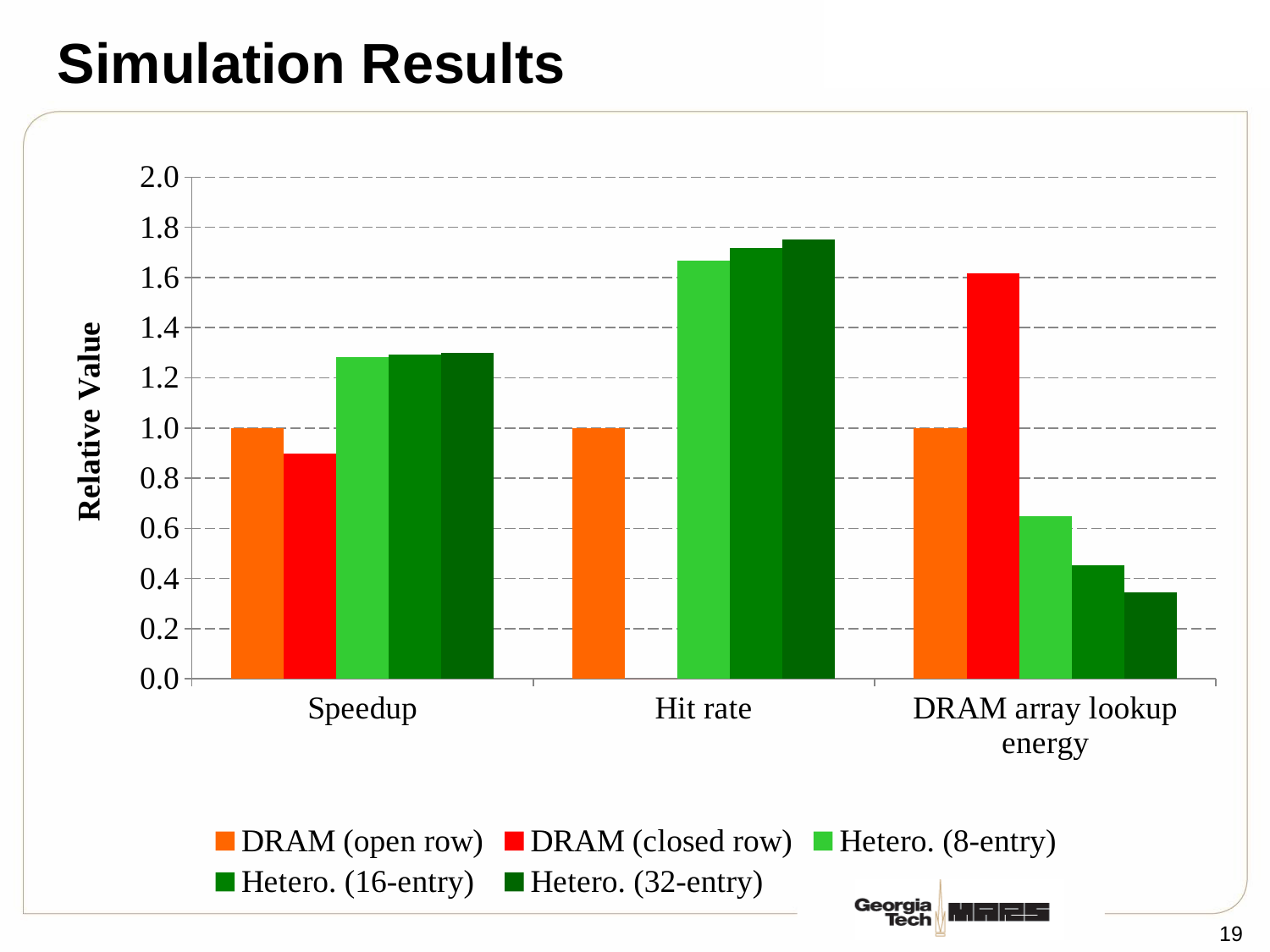
In the DRAM array lookup energy category, which series has the highest value? DRAM (closed row) In the DRAM array lookup energy category, which series has the lowest value? Hetero. (32-entry) How many series does the legend list? 5 What is the title of the y axis? Relative Value What kind of chart is shown on the slide? bar chart Is the Speedup value for DRAM (closed row) greater or less than 1.0? less Is the Hit rate value for Hetero. (32-entry) greater or less than 1.6? greater What is the value for DRAM (open row) in the Speedup category? 1.0 In the Hit rate category, which is larger: Hetero. (8-entry) or DRAM (open row)? Hetero. (8-entry) How many categories are shown on the x axis? 3 Is the DRAM array lookup energy value for Hetero. (8-entry) greater or less than 0.8? less In the DRAM array lookup energy category, do the Hetero. values rise or fall going from 8-entry to 32-entry? fall